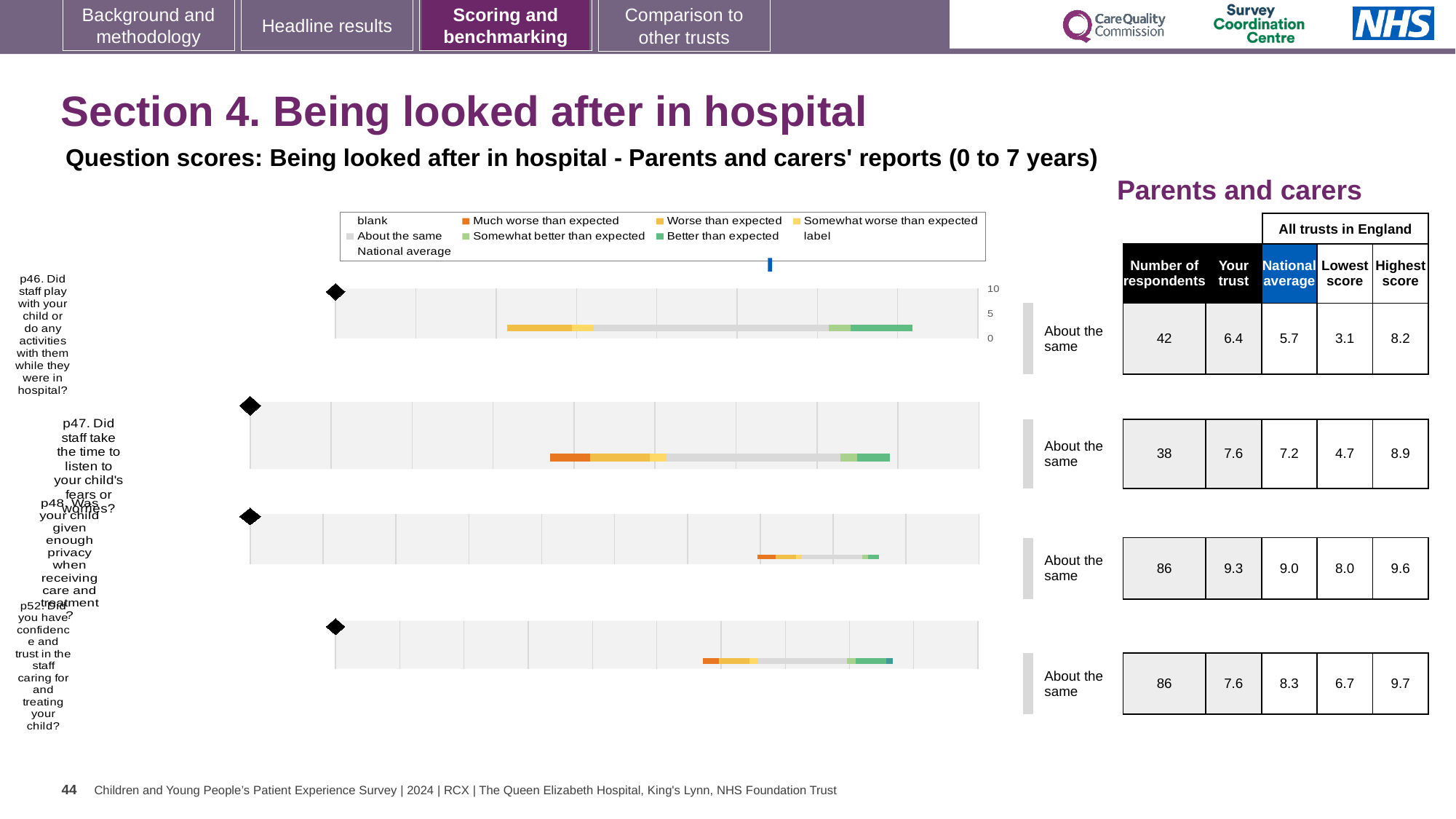
For p46, what is the difference between the 'Your trust' score and the national average? 0.7 How many questions (charts) are shown in the Being looked after in hospital section on this slide? 4 For p46, what is the national average score? 5.7 For p48 (Was your child given enough privacy when receiving care and treatment?), what is the highest score among all trusts in England? 9.6 Which question has the lowest 'Your trust' score on this slide? p46 For p46 (Did staff play with your child or do any activities with them while they were in hospital?), what is the 'Your trust' score? 6.4 Which question has the highest 'Your trust' score on this slide? p48 What kind of chart is used to show the question scores on this slide? bar chart For p47 (Did staff take the time to listen to your child's fears or worries?), how many respondents are there? 38 For p52, which is larger: the 'Your trust' score or the national average? National average What benchmark category is shown for p47 on this slide? About the same For p52 (Did you have confidence and trust in the staff caring for and treating your child?), what is the lowest score among all trusts in England? 6.7